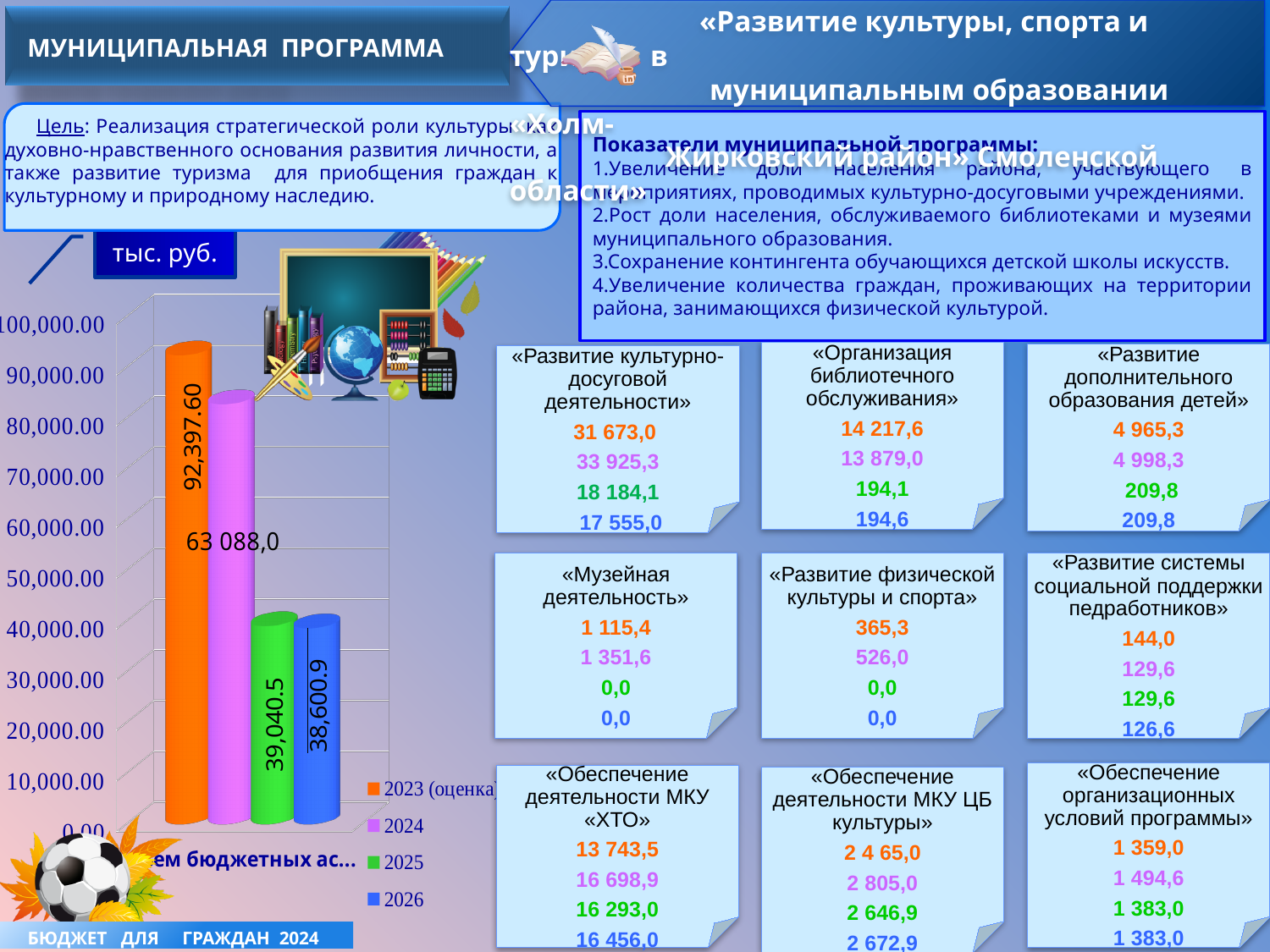
What type of chart is shown on the slide? bar chart What is the value for 2023 (оценка) in the bar chart? 92,397.60 What is the value for 2026 in the bar chart? 38,600.9 Which year has the highest value in the bar chart? 2023 (оценка) Do the values in the bar chart rise or fall from 2023 (оценка) to 2026? fall Which is larger in the bar chart, the value for 2024 or the value for 2025? 2024 What unit is indicated for the values in the bar chart? тыс. руб. What is the value for 2024 in the bar chart? 63 088,0 Which year has the lowest value in the bar chart? 2026 Is the value for 2024 in the bar chart greater or less than 60,000.00? greater How many series does the legend of the bar chart list? 4 What is the value for 2025 in the bar chart? 39,040.5